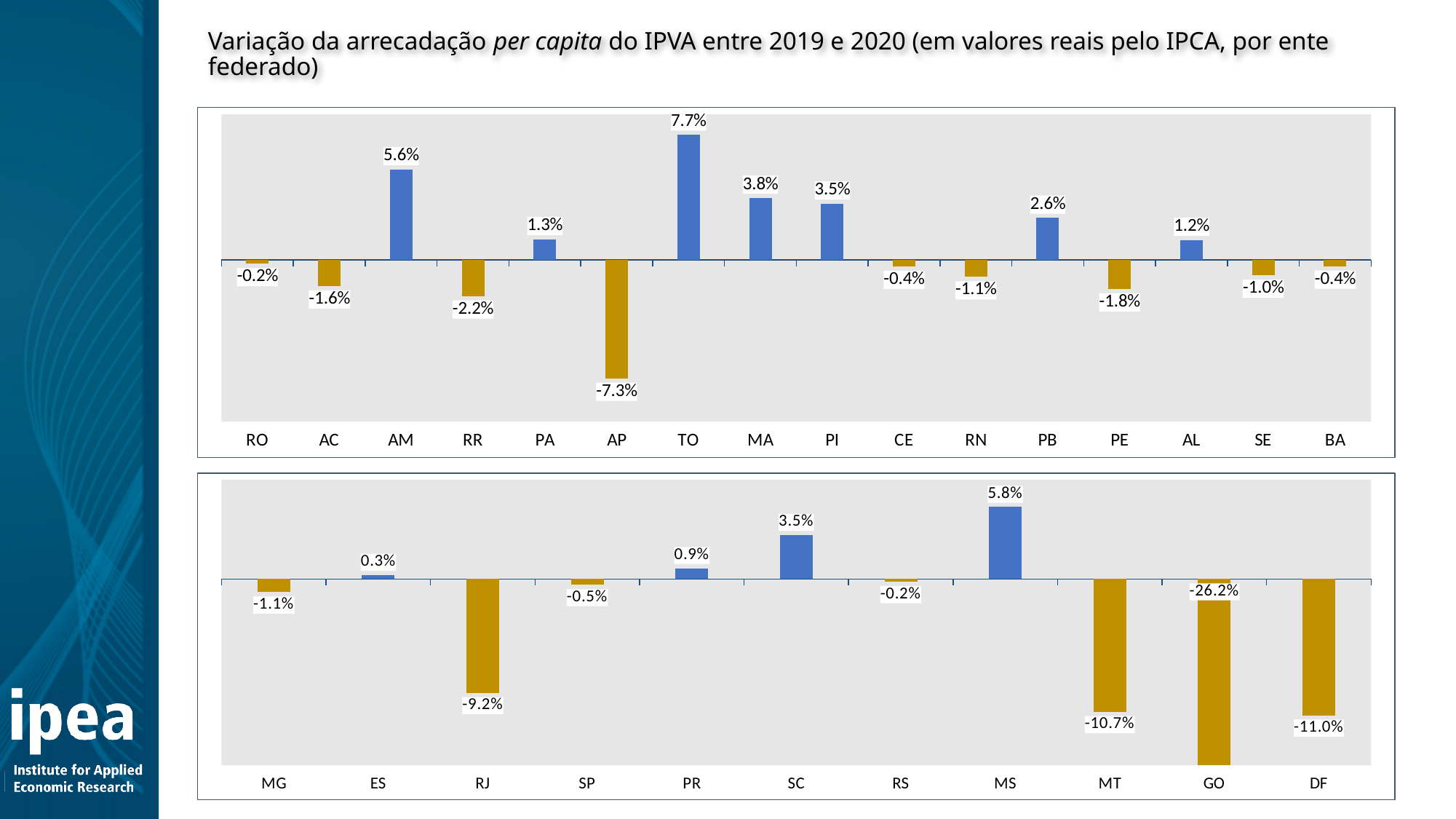
In the top chart, what is the value for TO? 7.7% In the top chart, what is the value for AP? -7.3% In the bottom chart, what is the difference between the values for MT and DF? 0.3 percentage points In the bottom chart, what is the value for GO? -26.2% In the bottom chart, what is the value for MS? 5.8% How many states are shown in the top chart? 16 In the bottom chart, which is larger, the value for SC or the value for PR? SC What type of chart is the bottom chart? Bar chart How many states are shown in the bottom chart? 11 In the bottom chart, which state has the lowest value? GO In the top chart, what is the difference between the values for AM and PB? 3.0 percentage points In the top chart, which state has the highest value? TO